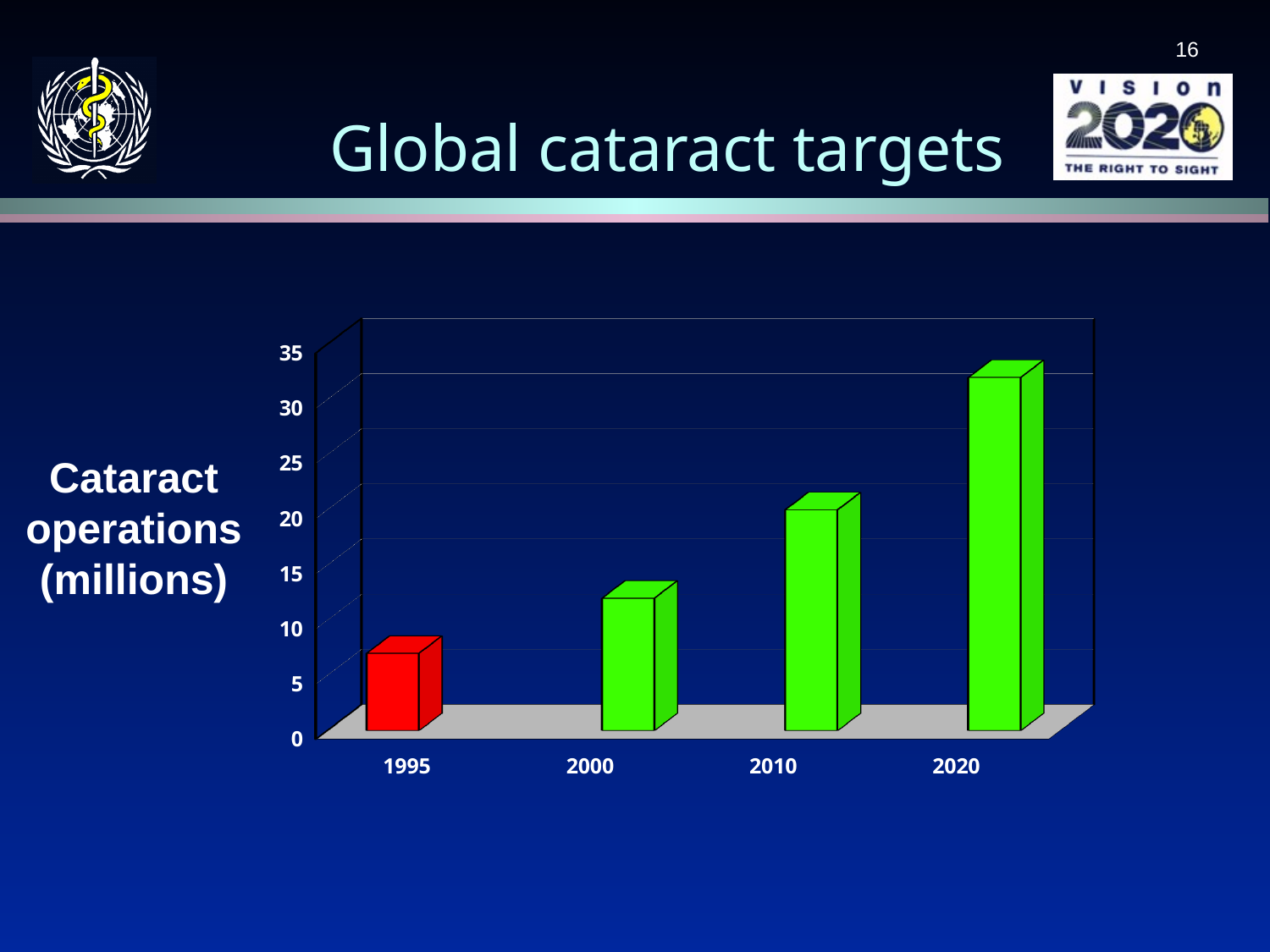
How many years are plotted on the chart? 4 Is the value for 1995 greater or less than 10? less Is the value for 2010 greater or less than 15? greater What colour is the bar for 1995? red Which is larger, the value for 2000 or the value for 2010? 2010 Which year has the lowest number of cataract operations? 1995 Is the value for 2020 greater or less than 30? greater Which year has the highest number of cataract operations? 2020 What kind of chart is shown on the slide? bar chart Do the values rise or fall from 1995 to 2020? rise What is the title of the slide containing the chart? Global cataract targets